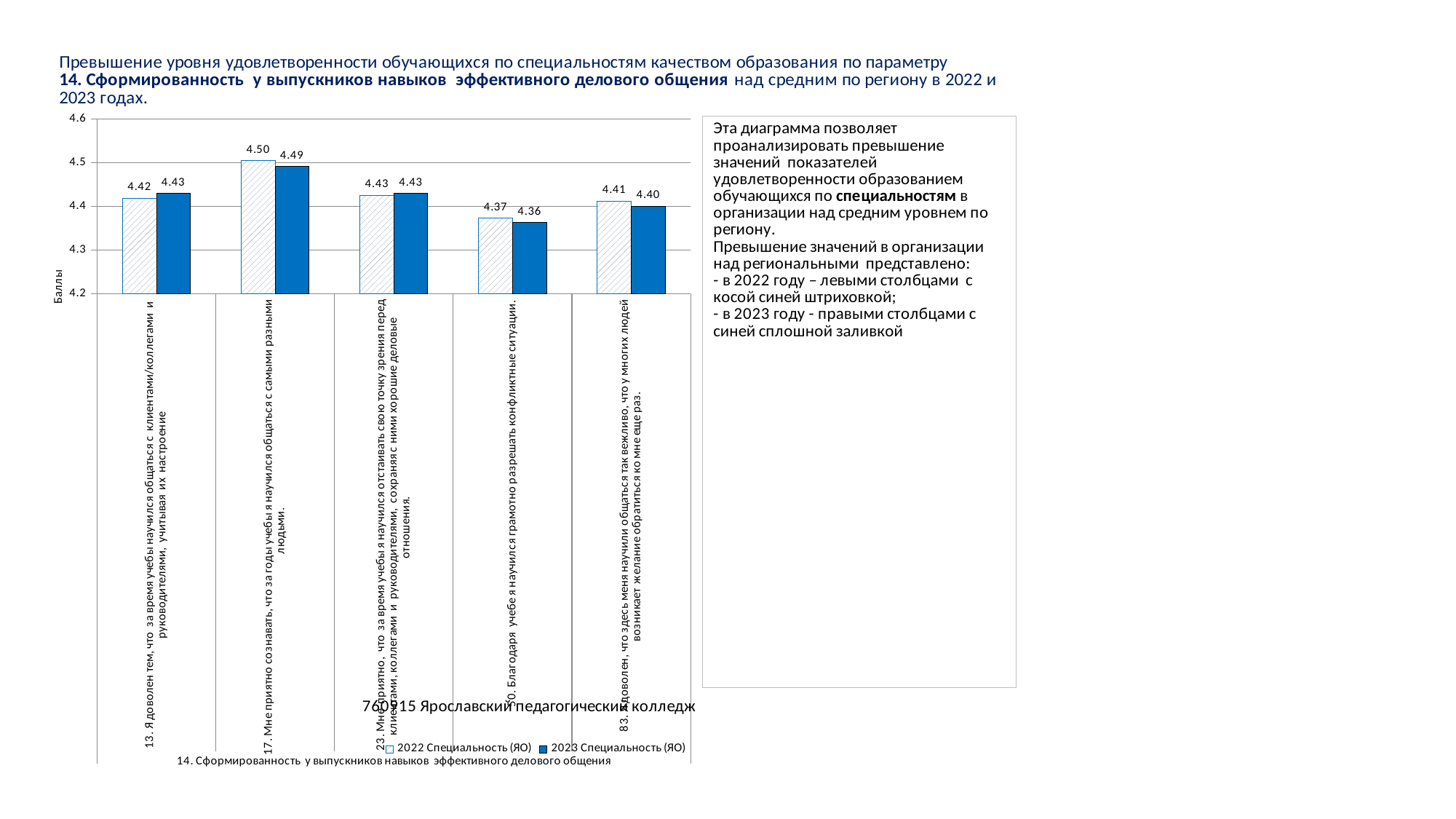
How many series does the chart legend list? 2 What are the two legend entries of the chart? 2022 Специальность (ЯО) and 2023 Специальность (ЯО) How many categories (statements) are plotted on the chart? 5 What is the 2023 Специальность (ЯО) value for statement 13? 4.43 What is the difference between the 2022 value for statement 17 (4.50) and the 2022 value for statement 50 (4.37)? 0.13 What is the 2023 Специальность (ЯО) value for statement 50 (Благодаря учебе я научился грамотно разрешать конфликтные ситуации)? 4.36 Which statement has the highest 2022 Специальность (ЯО) value? 17. Мне приятно сознавать, что за годы учебы я научился общаться с самыми разными людьми Which is larger for statement 83: the 2022 Специальность (ЯО) value or the 2023 Специальность (ЯО) value? 2022 Специальность (ЯО) What is the label of the vertical axis? Баллы Which statement has the lowest 2023 Специальность (ЯО) value? 50. Благодаря учебе я научился грамотно разрешать конфликтные ситуации What is the 2022 Специальность (ЯО) value for statement 17 (Мне приятно сознавать, что за годы учебы я научился общаться с самыми разными людьми)? 4.50 What type of chart is shown on the slide? bar chart